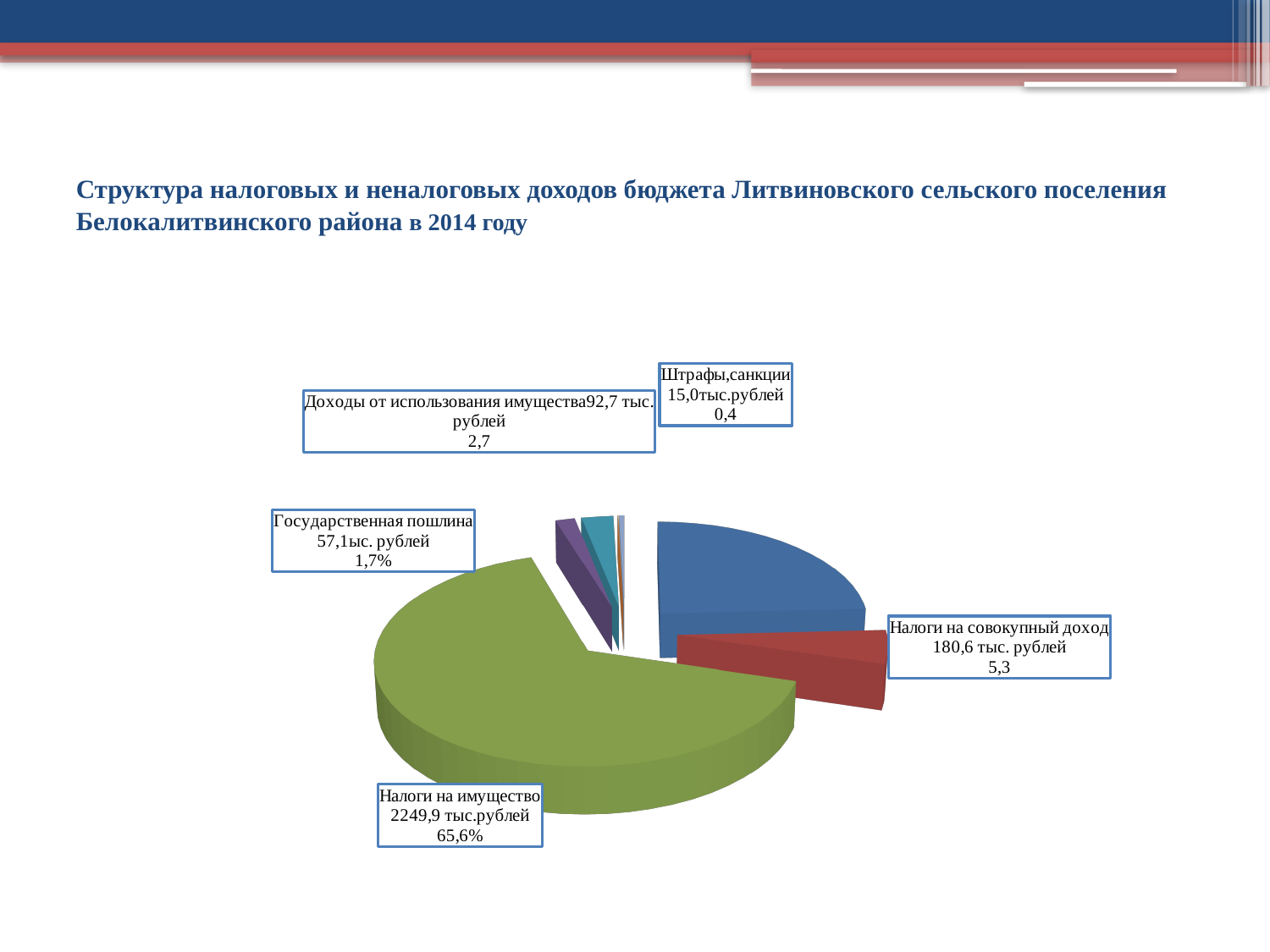
Which labelled category has the largest slice of the pie? Налоги на имущество What is the difference in тыс. рублей between Налоги на совокупный доход and Государственная пошлина? 123,5 What value is printed for Государственная пошлина? 57,1ыс. рублей What value is printed for Штрафы,санкции? 15,0тыс.рублей What value is printed for Налоги на имущество? 2249,9 тыс.рублей Which labelled category has the smallest slice of the pie? Штрафы,санкции What value is printed for Доходы от использования имущества? 92,7 тыс. рублей Which is larger, Налоги на совокупный доход or Доходы от использования имущества? Налоги на совокупный доход What share is printed for Государственная пошлина? 1,7% What percentage share is printed for Налоги на имущество? 65,6% What kind of chart is shown on the slide? pie chart What value is printed for Налоги на совокупный доход? 180,6 тыс. рублей